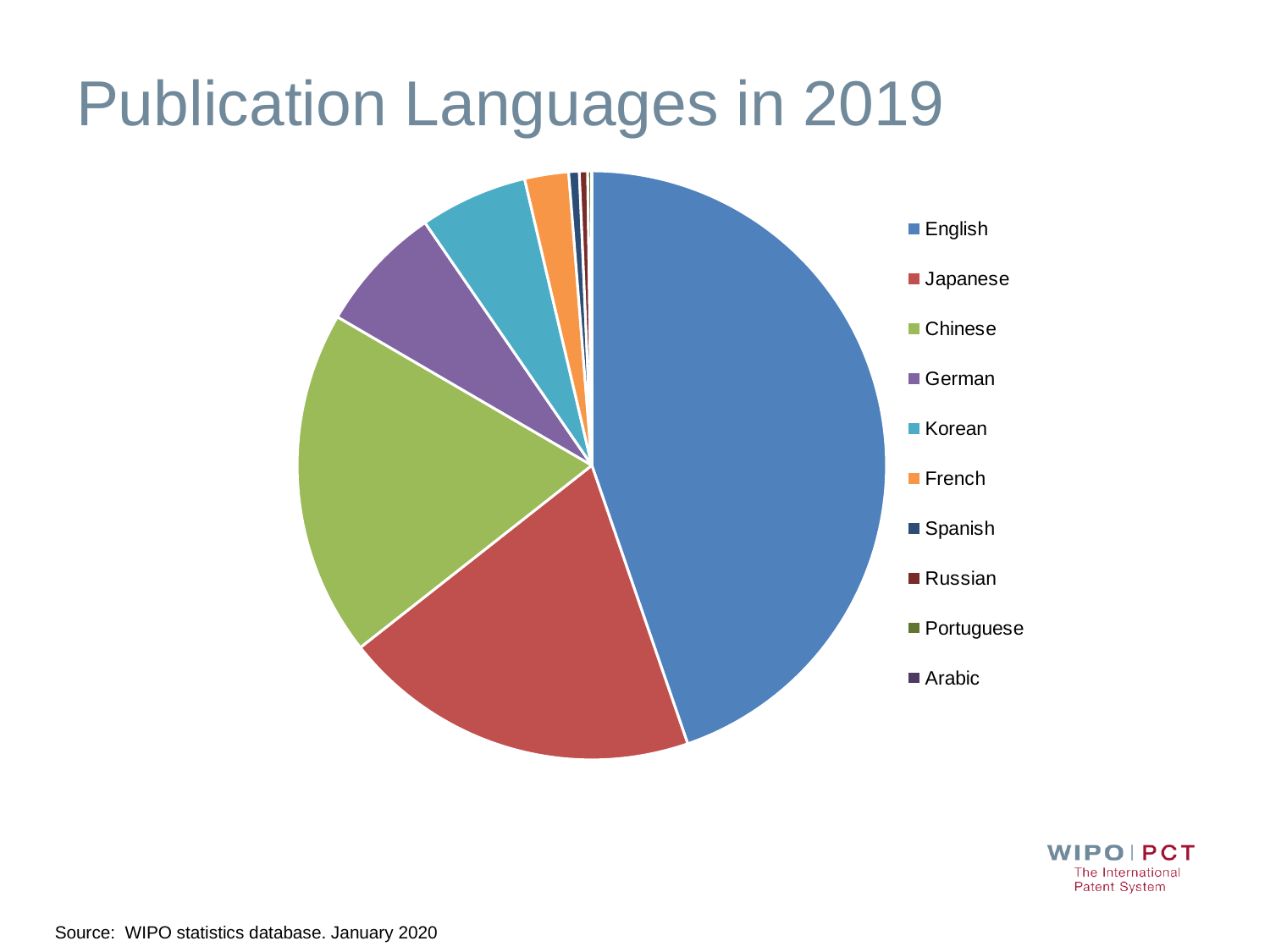
How many languages does the legend list? 10 Which slice is larger, English or Japanese? English Which language has the largest slice of the pie? English Which slice is larger, Chinese or German? Chinese What is the title of the chart on the slide? Publication Languages in 2019 Which slice is larger, German or Korean? German Which language is listed last in the legend? Arabic What kind of chart is shown on the slide? pie chart Which language is listed first in the legend? English How many slices does the pie chart have? 10